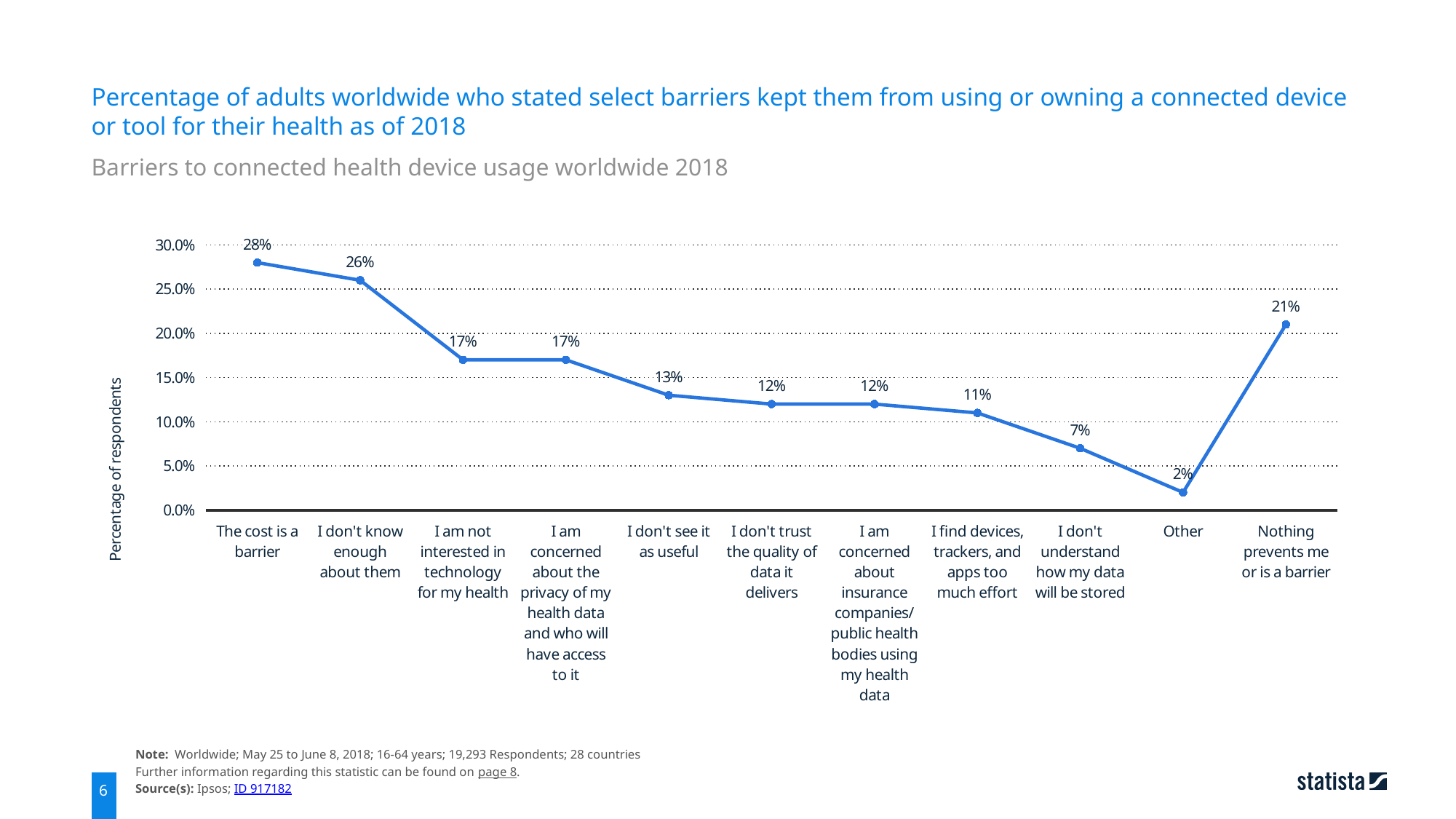
What kind of chart is shown on the slide? Line chart What is the label of the vertical axis? Percentage of respondents How many barrier categories are plotted on the chart? 11 What is the difference in percentage points between 'The cost is a barrier' and 'I don't know enough about them'? 2 Which is larger: the value for 'I don't see it as useful' or the value for 'I find devices, trackers, and apps too much effort'? I don't see it as useful What percentage of respondents said they don't understand how their data will be stored? 7% What percentage of respondents said nothing prevents them or is a barrier? 21% Which barrier has the highest percentage of respondents? The cost is a barrier What is the difference in percentage points between 'Nothing prevents me or is a barrier' and 'Other'? 19 What percentage of respondents stated that the cost is a barrier? 28% Which category has the lowest percentage of respondents? Other Do the values rise or fall from 'The cost is a barrier' to 'Other'? Fall